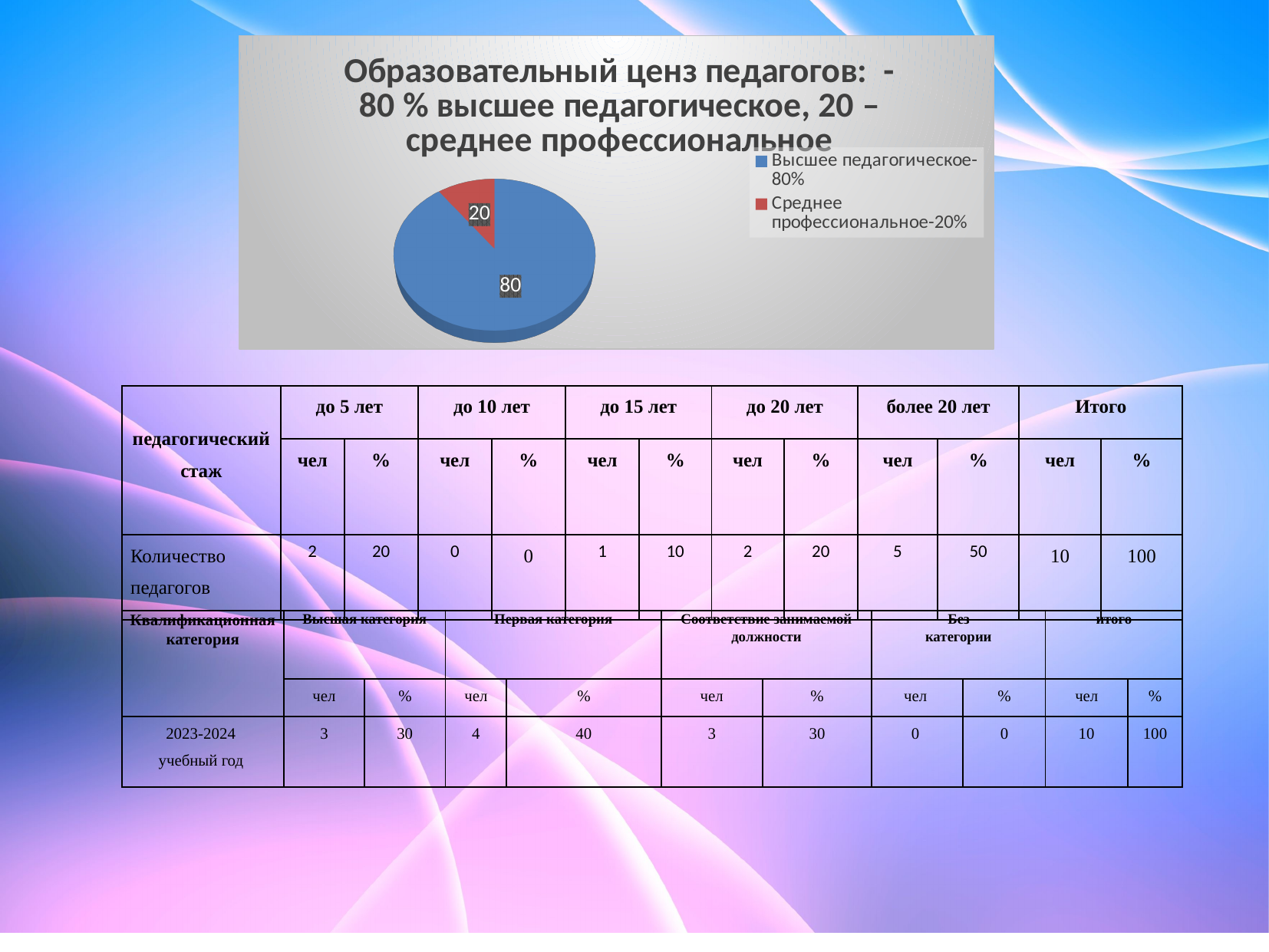
How many slices does the pie chart have? 2 Which slice of the pie chart is the smallest? Среднее профессиональное What is the data label on the slice for Среднее профессиональное? 20 What colour is the slice for Высшее педагогическое in the pie chart? blue What is the difference between the values for Высшее педагогическое and Среднее профессиональное? 60 Which is larger: the slice for Высшее педагогическое or the slice for Среднее профессиональное? Высшее педагогическое What is the data label on the slice for Высшее педагогическое? 80 What colour is the slice for Среднее профессиональное in the pie chart? red What share of the pie does the Среднее профессиональное slice represent? 20% What kind of chart is shown on the slide? pie chart Which slice of the pie chart is the largest? Высшее педагогическое How many entries does the legend of the pie chart list? 2